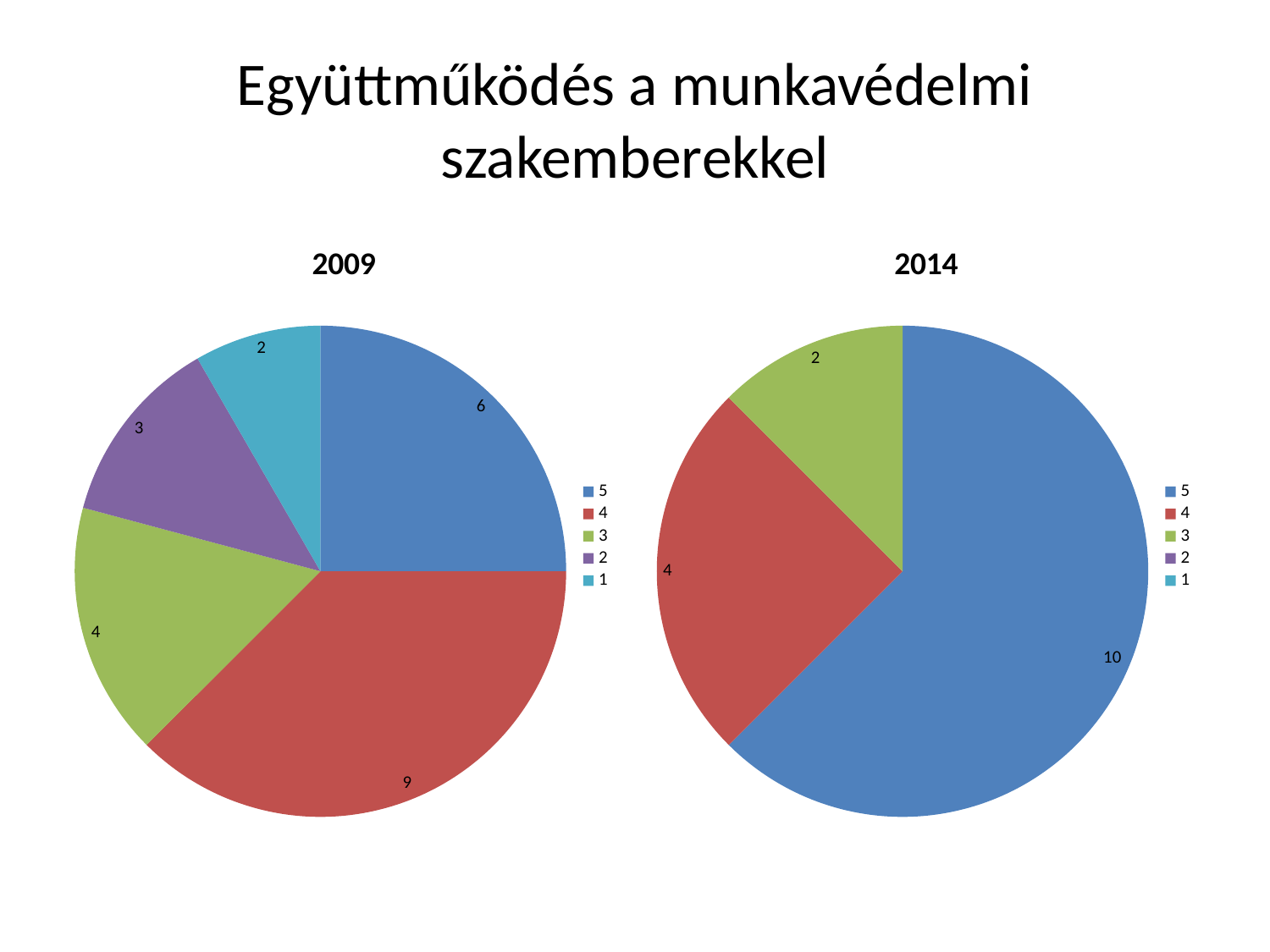
In the 2014 pie chart, what is the value of the slice for category 3? 2 In the 2009 pie chart, what is the value of the slice for category 4? 9 In the 2014 pie chart, what is the value of the slice for category 5? 10 What share of the 2014 pie does the slice for category 5 represent? 62.5% What type of chart is used for the 2009 data? Pie chart In the 2014 pie chart, which category has the largest slice? 5 In the 2014 pie chart, which is larger, the slice for category 4 or the slice for category 3? 4 In the 2009 pie chart, what is the value of the slice for category 1? 2 In the 2009 pie chart, which category has the smallest slice? 1 In the 2009 pie chart, what is the difference between the values for category 4 and category 5? 3 How many slices does the 2014 pie chart have? 3 In the 2009 pie chart, which category has the largest slice? 4